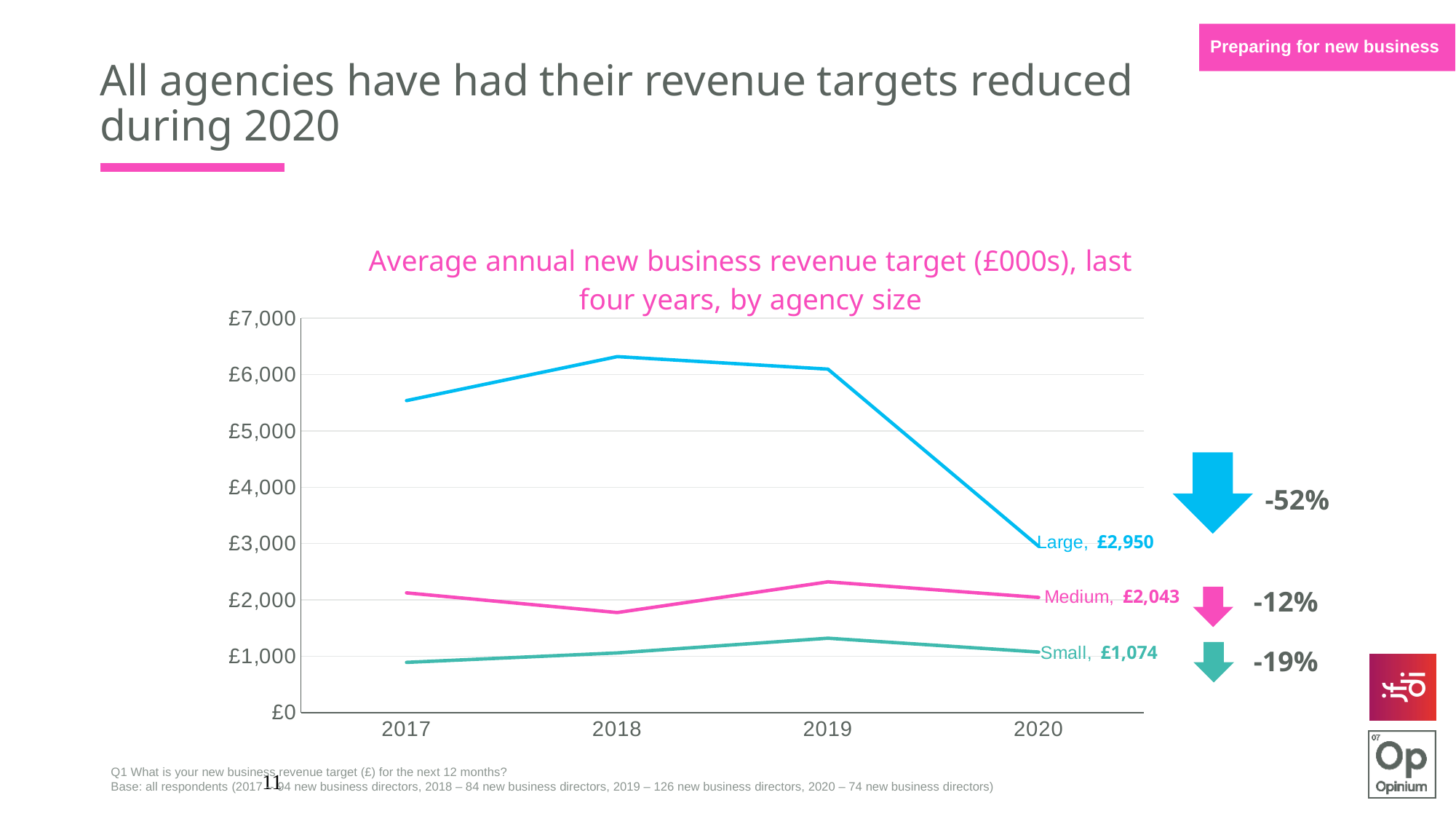
Which series has the highest value in 2020? Large What is the value for Medium agencies in 2020? £2,043 Which is larger in 2020, the Medium value or the Small value? Medium How many years are shown on the x axis? 4 Does the Large series rise or fall from 2019 to 2020? fall Is the value for Medium agencies in 2018 greater or less than £2,000? less What kind of chart is shown on the slide? line chart What is the value for Large agencies in 2020? £2,950 What is the value for Small agencies in 2020? £1,074 How many series are plotted on the chart? 3 What is the difference between the Large and Medium values in 2020? £907 Is the value for Large agencies in 2018 greater or less than £6,000? greater